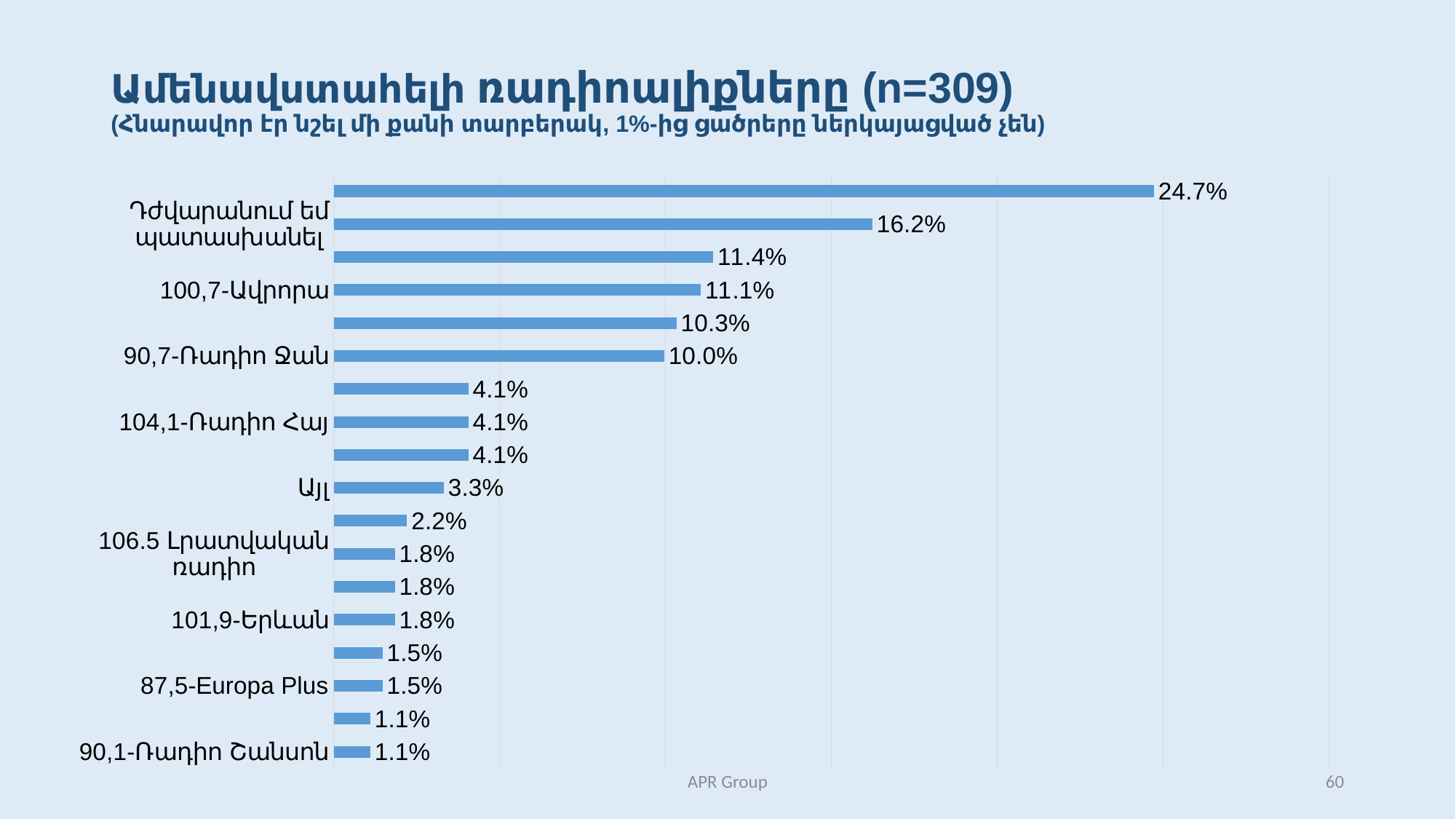
What is the highest value shown in the chart? 24.7% What is the difference between the values for 100,7-Ավրորա and 90,7-Ռադիո Ջան? 1.1% What is the value for 100,7-Ավրորա? 11.1% Which has the larger value, 104,1-Ռադիո Հայ or Այլ? 104,1-Ռադիո Հայ What is the value for 90,7-Ռադիո Ջան? 10.0% How many bars are plotted in the chart? 18 What is the value for Այլ? 3.3% What is the lowest value shown in the chart? 1.1% What sample size (n) is given in the chart title? 309 What is the value for 101,9-Երևան? 1.8% What type of chart is shown on the slide? bar chart What is the value for 87,5-Europa Plus? 1.5%